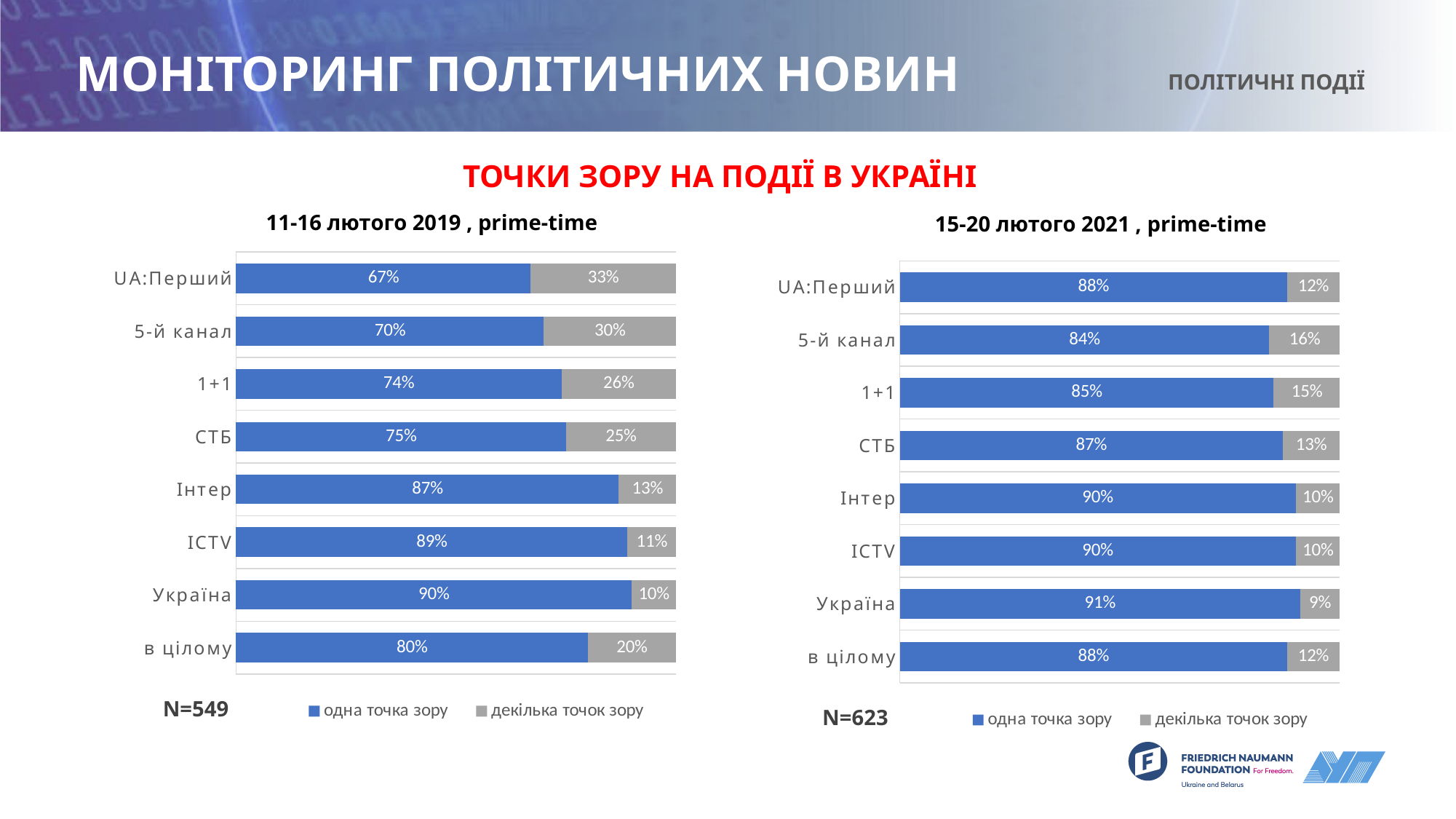
In the 15-20 лютого 2021 chart, what is the total of the stacked bar for 'в цілому'? 100% What type of chart is the 11-16 лютого 2019 chart? Stacked bar chart In the 11-16 лютого 2019 chart, what is the value of 'одна точка зору' for UA:Перший? 67% How many series does the legend of the 15-20 лютого 2021 chart list? 2 In the 15-20 лютого 2021 chart, which channel has the lowest share of 'одна точка зору'? 5-й канал In the 15-20 лютого 2021 chart, what is the value of 'декілька точок зору' for 5-й канал? 16% In the 11-16 лютого 2019 chart, what is the difference between the 'одна точка зору' values for Інтер and СТБ? 12% How many channels/categories are shown in the 11-16 лютого 2019 chart? 8 In the 11-16 лютого 2019 chart, which channel has the highest share of 'одна точка зору'? Україна In the 11-16 лютого 2019 chart, what is the 'декілька точок зору' value for 'в цілому'? 20% What sample size (N) is shown for the 15-20 лютого 2021 chart? N=623 In the 15-20 лютого 2021 chart, which is larger: the 'одна точка зору' value for 1+1 or for СТБ? СТБ